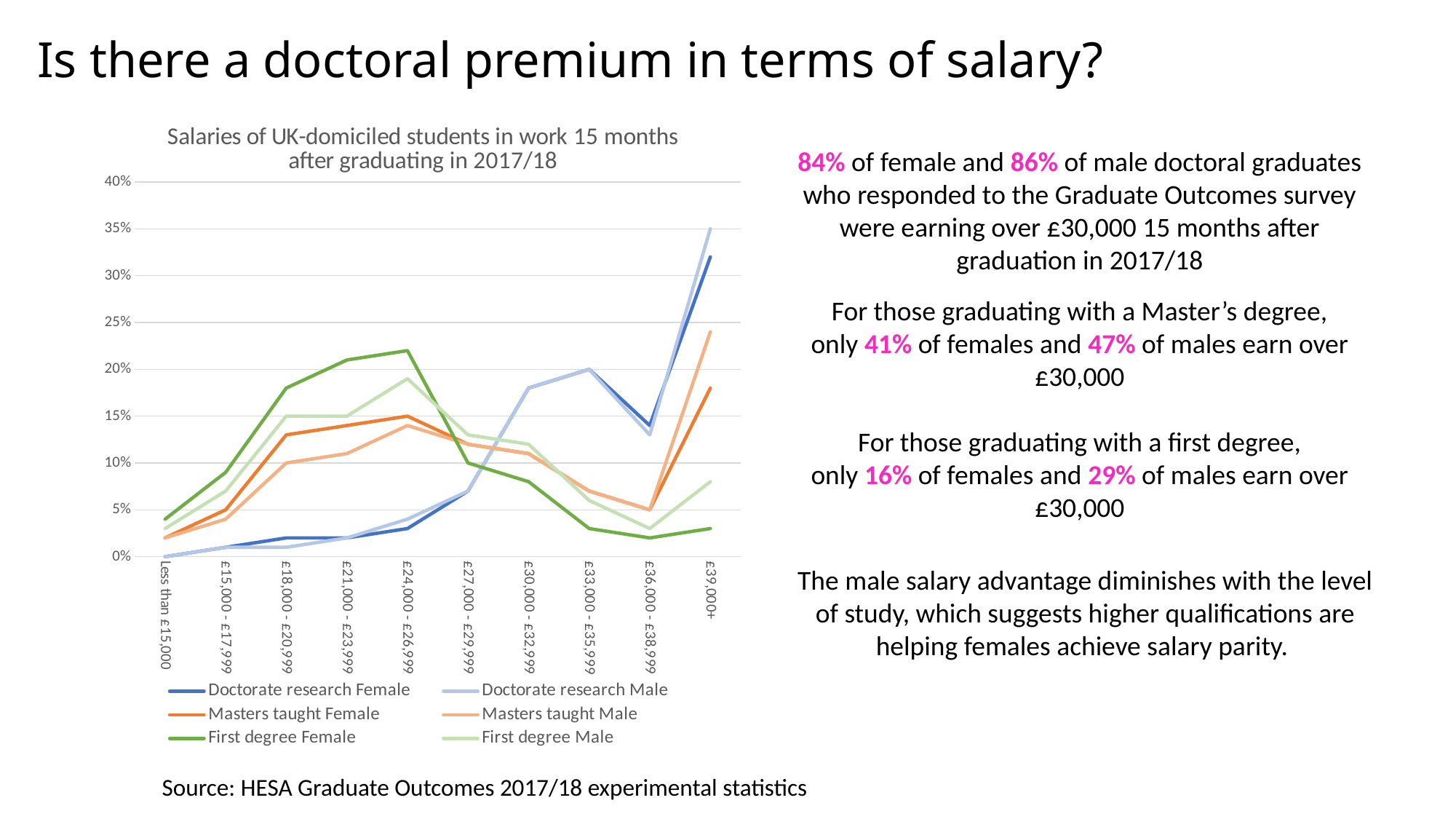
Which series has the highest value in the £39,000+ band? Doctorate research Male Which series has the lowest value in the £39,000+ band? First degree Female How many series does the chart's legend list? 6 How many salary bands are shown along the x axis of the chart? 10 Is the value for First degree Female in the £24,000 - £26,999 band greater or less than 20%? greater In the £18,000 - £20,999 band, which is larger: First degree Female or Doctorate research Female? First degree Female Is the value for Masters taught Female in the £36,000 - £38,999 band greater or less than 10%? less Does the Doctorate research Female line rise or fall from the Less than £15,000 band to the £27,000 - £29,999 band? rise Is the value for First degree Male in the £39,000+ band greater or less than 10%? less What kind of chart is shown on the slide? line chart What is the title of the chart? Salaries of UK-domiciled students in work 15 months after graduating in 2017/18